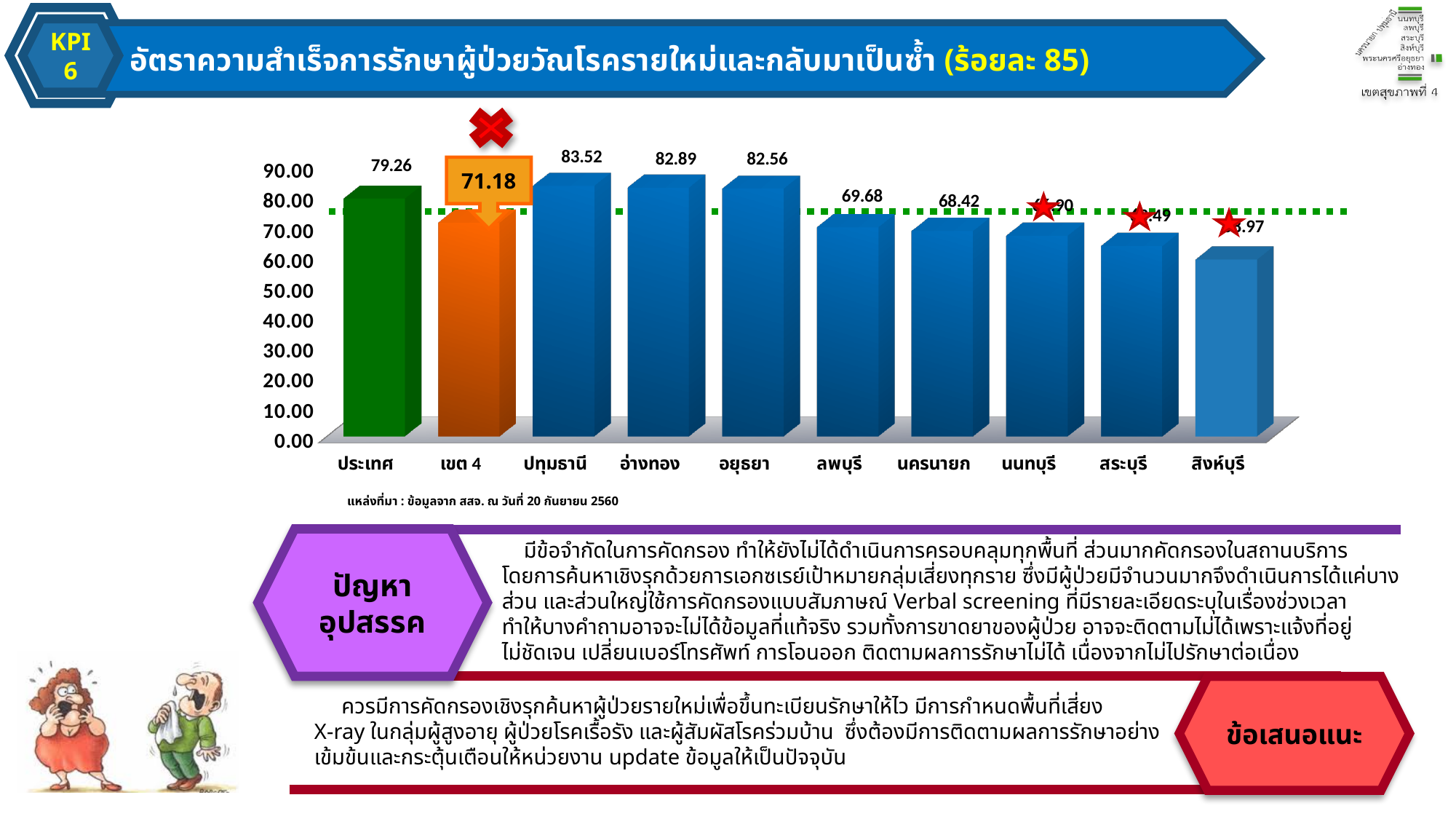
What is the value for ปทุมธานี? 83.52 Which category has the highest value? ปทุมธานี What is the value for อ่างทอง? 82.89 How many categories are shown on the x axis? 10 Is the value for สิงห์บุรี greater or less than 70.00? less What is the difference between the values for ประเทศ and เขต 4? 8.08 What is the value for นครนายก? 68.42 Which category has the lowest value? สิงห์บุรี What is the value for เขต 4? 71.18 Which is larger, the value for อยุธยา or the value for ลพบุรี? อยุธยา What is the value for ลพบุรี? 69.68 What is the value for ประเทศ? 79.26